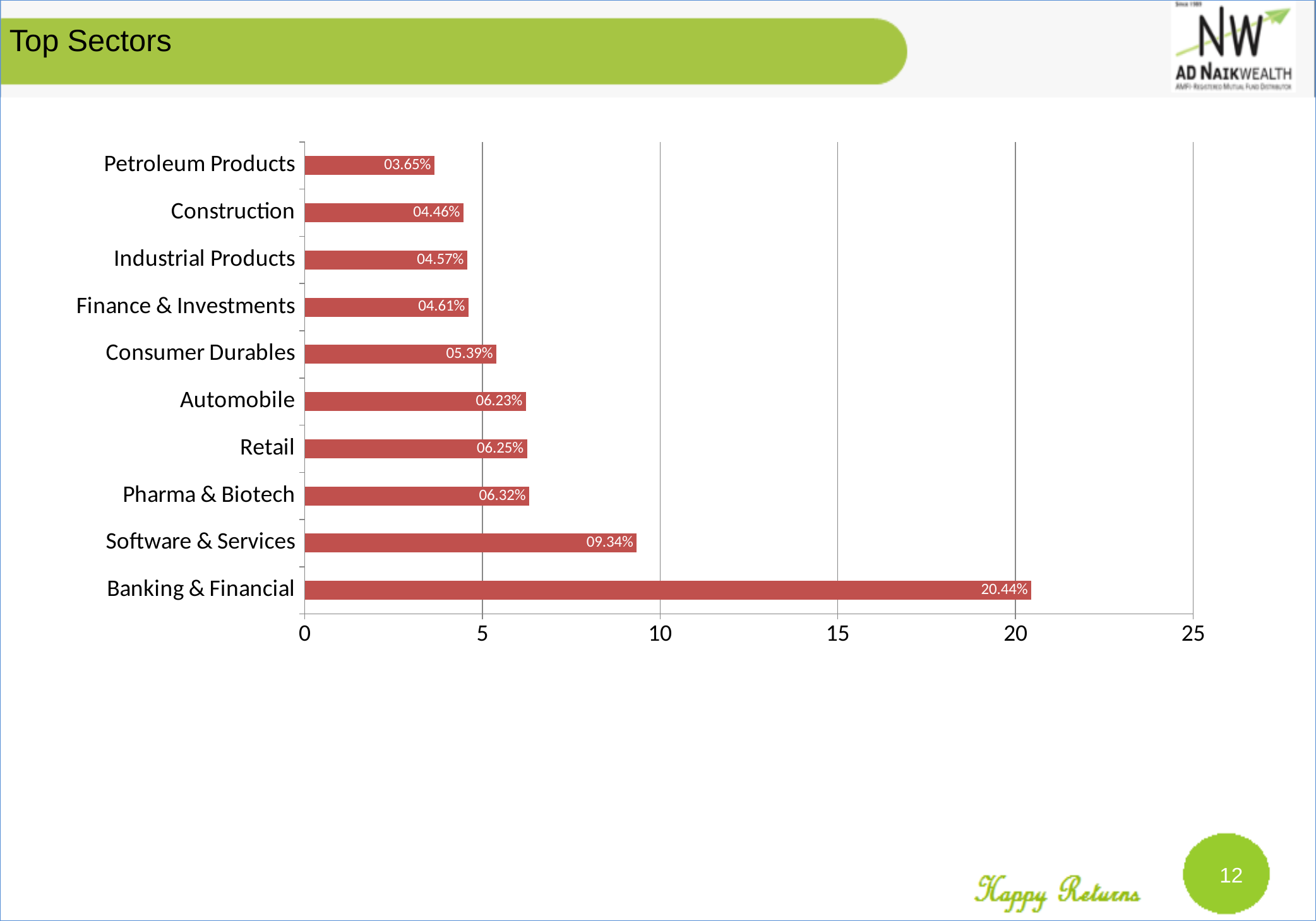
What is the value for Petroleum Products? 03.65% What is the value for Software & Services? 09.34% Is the value for Software & Services greater or less than 10? less What kind of chart is shown on the slide? bar chart How many sectors are shown in the chart? 10 What is the value for Consumer Durables? 05.39% What is the title of the slide containing the chart? Top Sectors What is the value for Banking & Financial? 20.44% Which sector has the lowest value? Petroleum Products Which sector has the highest value? Banking & Financial What is the difference between the values for Banking & Financial and Software & Services? 11.10% Which is larger, the value for Automobile or the value for Consumer Durables? Automobile